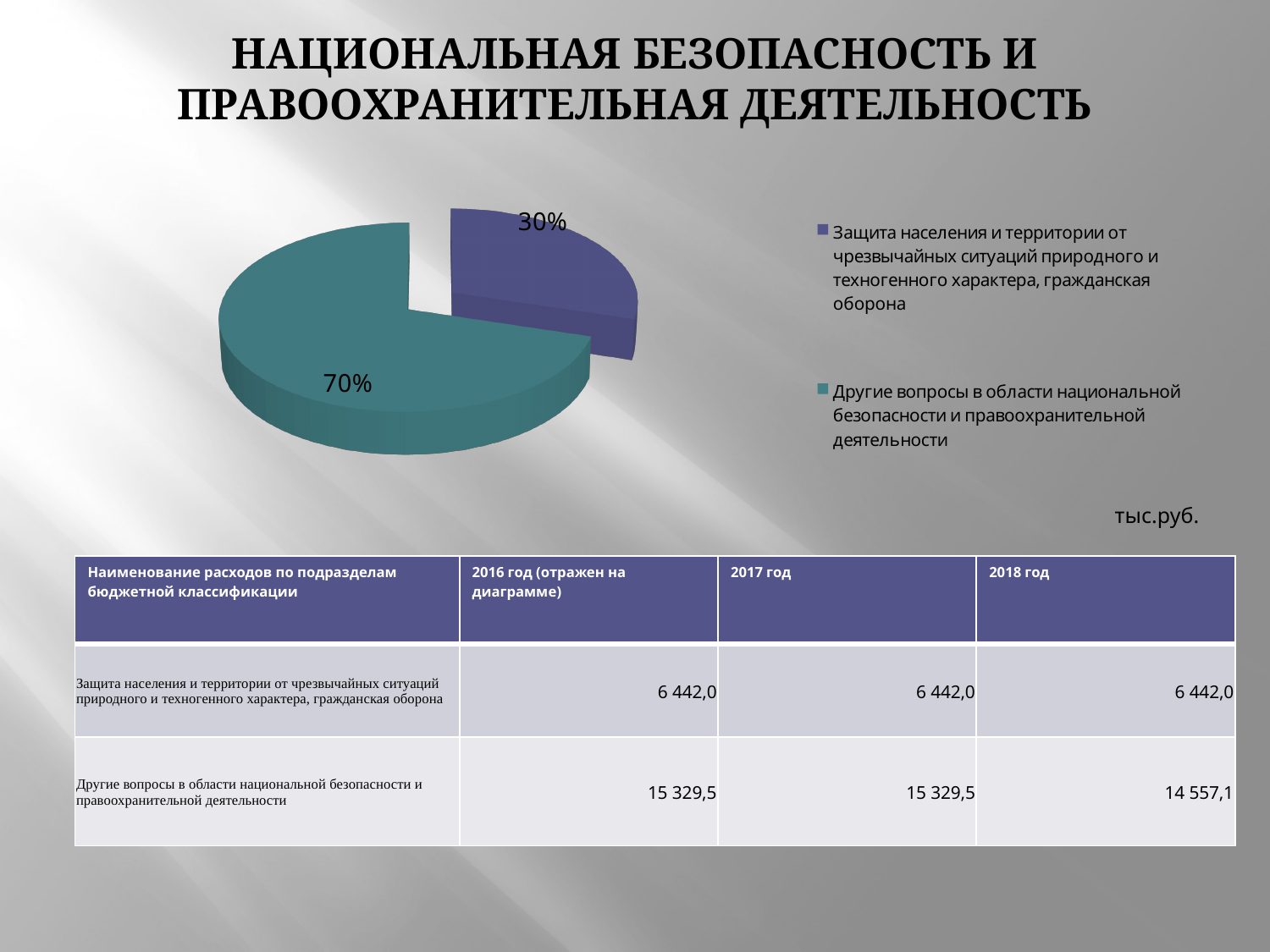
Which category has the smallest slice in the pie chart? Защита населения и территории от чрезвычайных ситуаций природного и техногенного характера, гражданская оборона Which year's data does the pie chart reflect, according to the table header? 2016 год Is the share for "Защита населения и территории от чрезвычайных ситуаций" greater or less than 50%? less What share of the pie does "Защита населения и территории от чрезвычайных ситуаций природного и техногенного характера, гражданская оборона" take? 30% By how many percentage points does the "Другие вопросы" slice exceed the "Защита населения" slice? 40 What colour is the slice representing "Другие вопросы в области национальной безопасности и правоохранительной деятельности"? Teal What kind of chart is shown on the slide? Pie chart Which slice is larger: "Защита населения и территории от чрезвычайных ситуаций" or "Другие вопросы в области национальной безопасности"? Другие вопросы в области национальной безопасности и правоохранительной деятельности What share of the pie does "Другие вопросы в области национальной безопасности и правоохранительной деятельности" take? 70% How many entries does the legend of the pie chart list? 2 How many slices does the pie chart have? 2 Which category has the largest slice in the pie chart? Другие вопросы в области национальной безопасности и правоохранительной деятельности